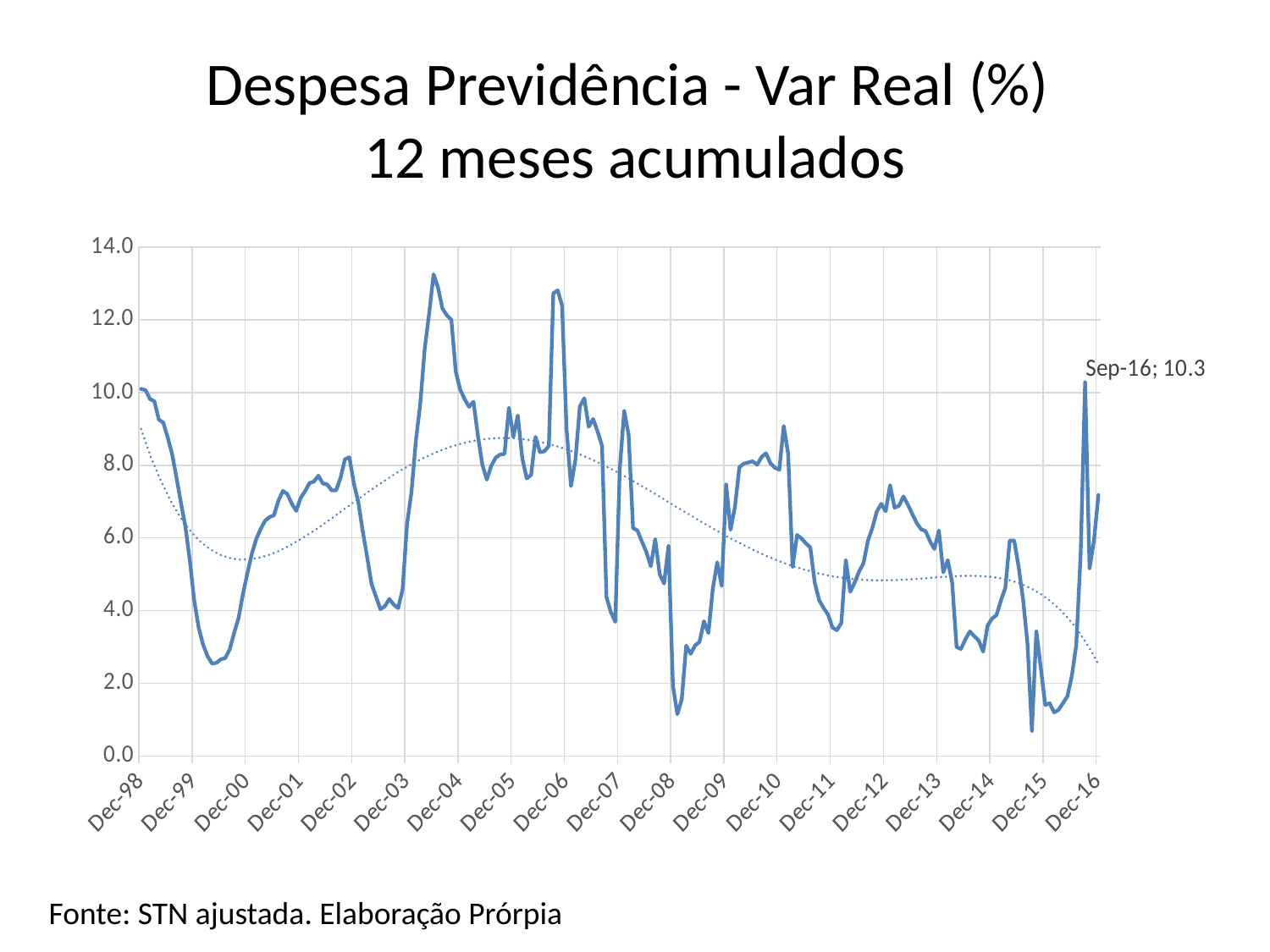
Is the value at Dec-08 greater or less than 4.0? less Which is larger, the value at Dec-04 or the value at Dec-08? Dec-04 Is the highest value reached by the line greater or less than 12.0? greater Does the line rise or fall between Dec-98 and Dec-99? fall How many date labels are shown on the x axis? 19 Which point on the chart has a printed data label? Sep-16 What kind of chart is shown on the slide? line chart Is the value at Dec-04 greater or less than 8.0? greater What is the title of the chart? Despesa Previdência - Var Real (%) 12 meses acumulados Does the line rise or fall between Dec-15 and Dec-16? rise What value is shown by the data label for Sep-16? 10.3